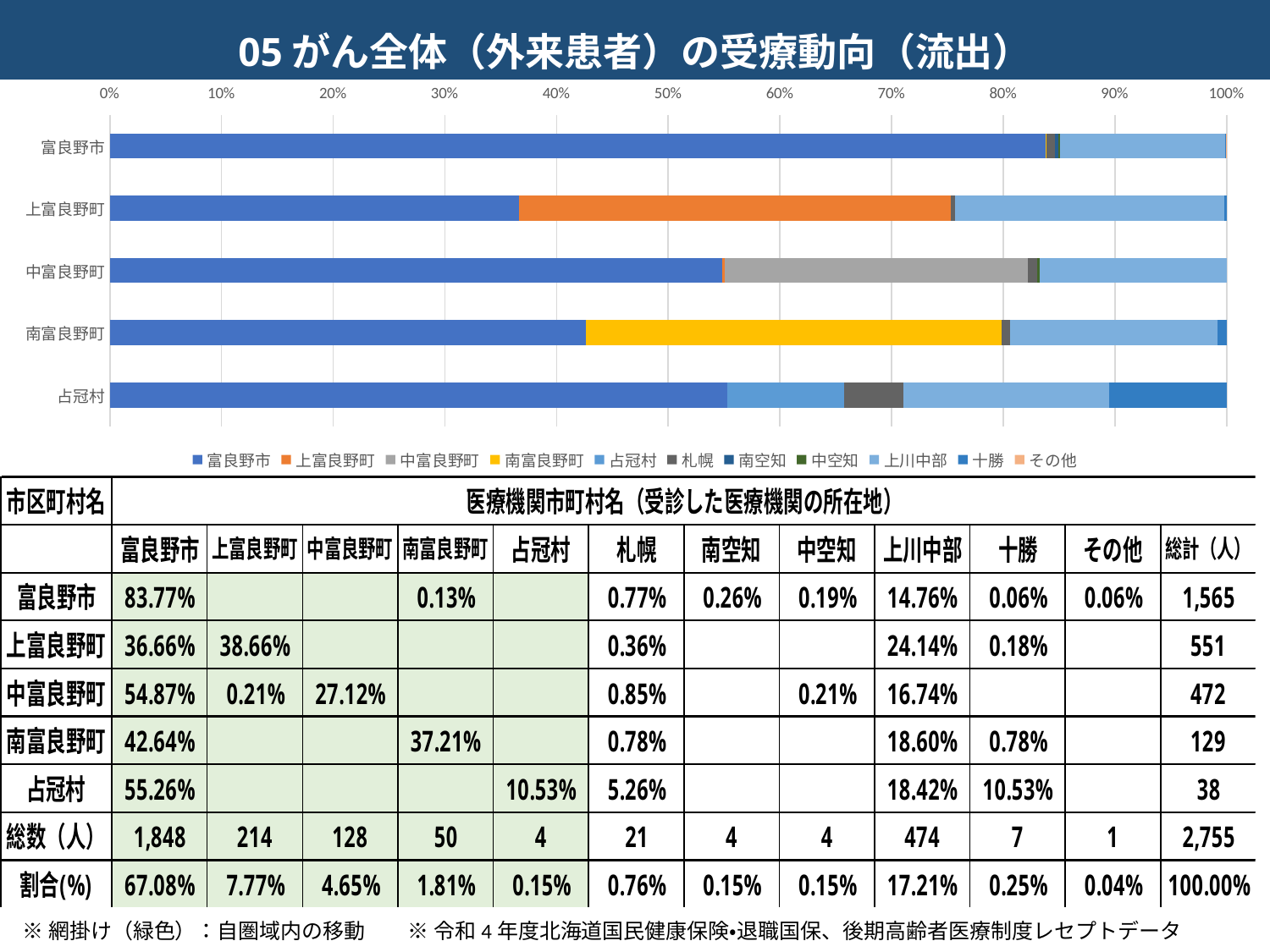
Is the 富良野市 segment of the 占冠村 bar greater or less than 60%? less What share of 富良野市 patients received care in 富良野市? 83.77% For 中富良野町, what is the difference between the 富良野市 share (54.87%) and the 中富良野町 share (27.12%)? 27.75% Which municipality has the smallest 富良野市 segment in its bar? 上富良野町 What share of 上富良野町 patients received care in 上富良野町? 38.66% What kind of chart is shown on the slide? Stacked bar chart What colour represents 上富良野町 in the chart legend? Orange What share of 占冠村 patients received care in 十勝? 10.53% How many municipalities (categories) are plotted on the y axis of the chart? 5 How many series does the chart legend list? 11 What share of 南富良野町 patients received care in 上川中部? 18.60% Which municipality has the largest 富良野市 segment in its bar? 富良野市